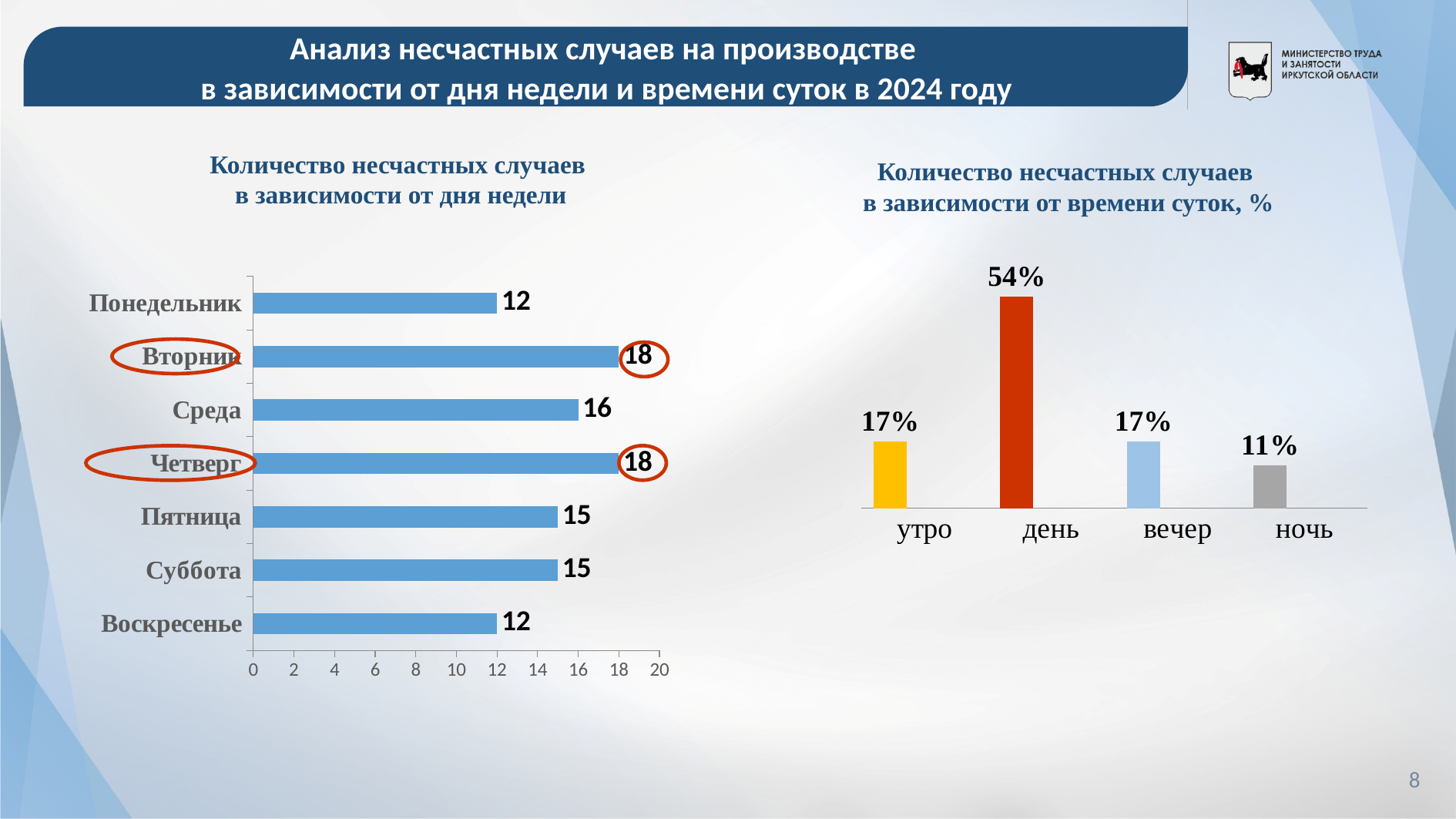
In the left chart (Количество несчастных случаев в зависимости от дня недели), what is the value for Среда? 16 In the right chart (by time of day), how many categories are shown? 4 What kind of chart is the left chart (by day of the week)? Bar chart In the right chart (by time of day), what is the difference between день and ночь? 43% In the right chart (Количество несчастных случаев в зависимости от времени суток, %), what is the value for день? 54% In the left chart (by day of the week), which is larger, Среда or Суббота? Среда In the left chart (by day of the week), what is the value for Понедельник? 12 In the right chart (by time of day), which category has the lowest value? ночь In the left chart (by day of the week), how many categories are shown? 7 In the left chart (by day of the week), what is the difference between Вторник and Пятница? 3 In the left chart (by day of the week), which days have the highest value? Вторник and Четверг In the right chart (by time of day), what colour is the bar for день? Red